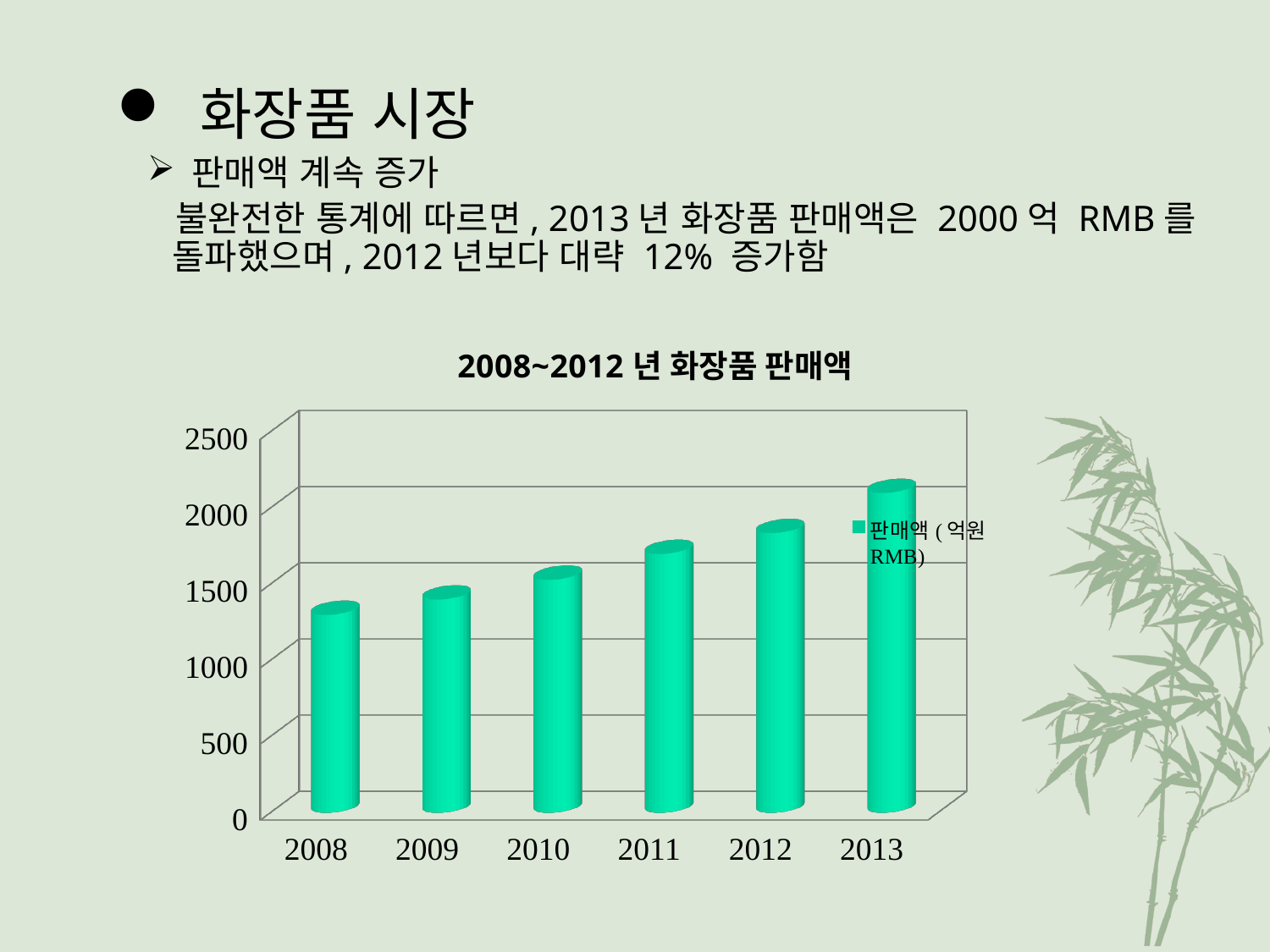
Which is larger, the value for 2011 or the value for 2009? 2011 Is the value for 2013 greater or less than 2000? greater Is the value for 2008 greater or less than 1500? less How many years are shown on the x axis of the chart? 6 Which year has the highest value in the chart? 2013 How many series does the chart's legend list? 1 Do the values rise or fall from 2008 to 2013? rise What is the title of the chart? 2008~2012 년 화장품 판매액 What is the legend entry for the series in the chart? 판매액 (억원 RMB) What kind of chart is shown on the slide? bar chart Which year has the lowest value in the chart? 2008 Is the value for 2012 greater or less than 2000? less